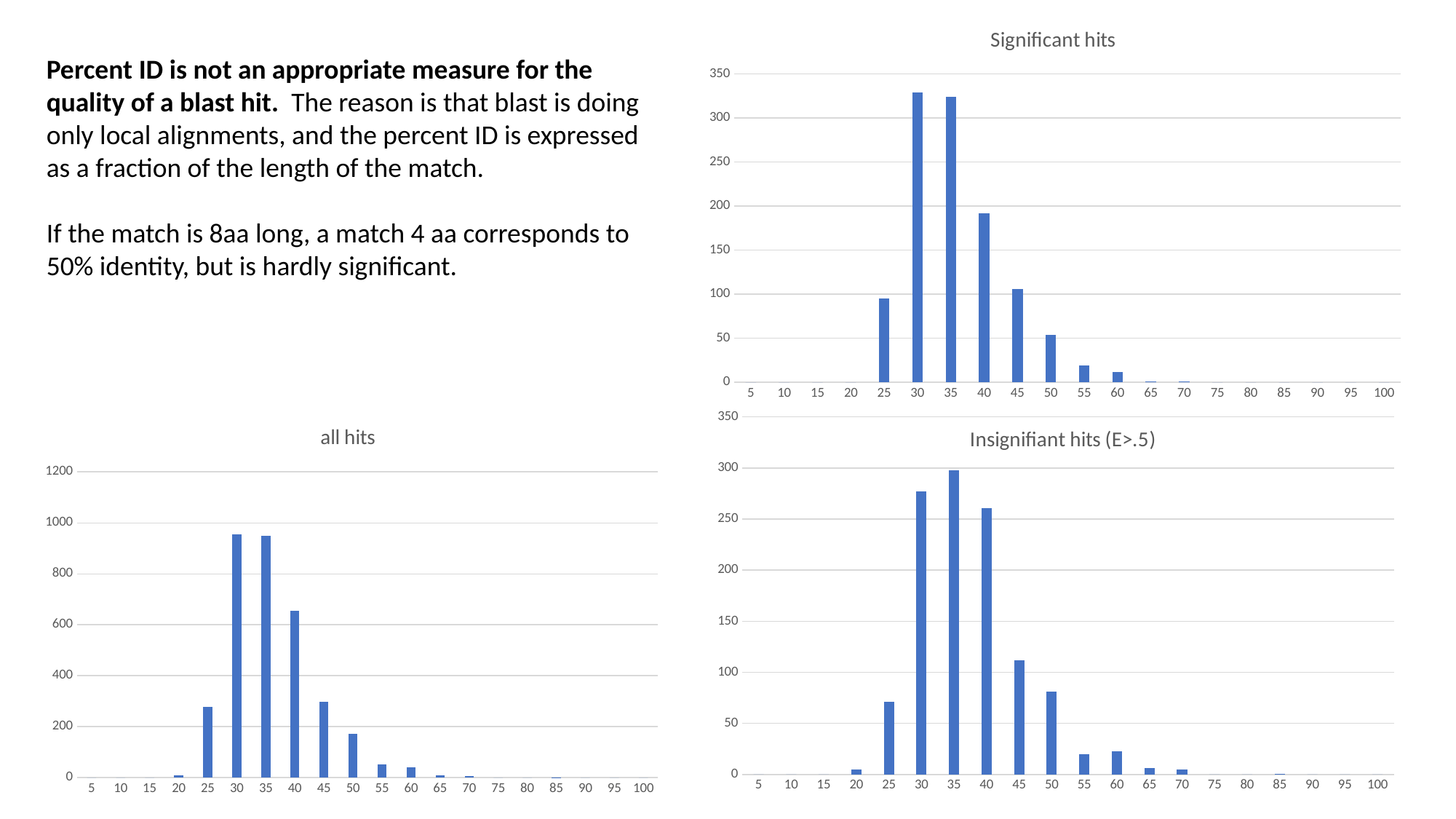
What kind of chart is the "all hits" chart? bar chart In the "all hits" chart, which is larger, the value for 40 or the value for 45? 40 In the "all hits" chart, is the value for 25 greater or less than 200? greater In the "Significant hits" chart, is the value for 40 greater or less than 150? greater In the "all hits" chart, is the value for 40 greater or less than 600? greater In the "Significant hits" chart, which is larger, the value for 45 or the value for 50? 45 In the "all hits" chart, do the values rise or fall along the x axis from 35 to 60? fall How many categories are shown on the x axis of the "all hits" chart? 20 In the "Insignifiant hits (E>.5)" chart, which category has the highest bar? 35